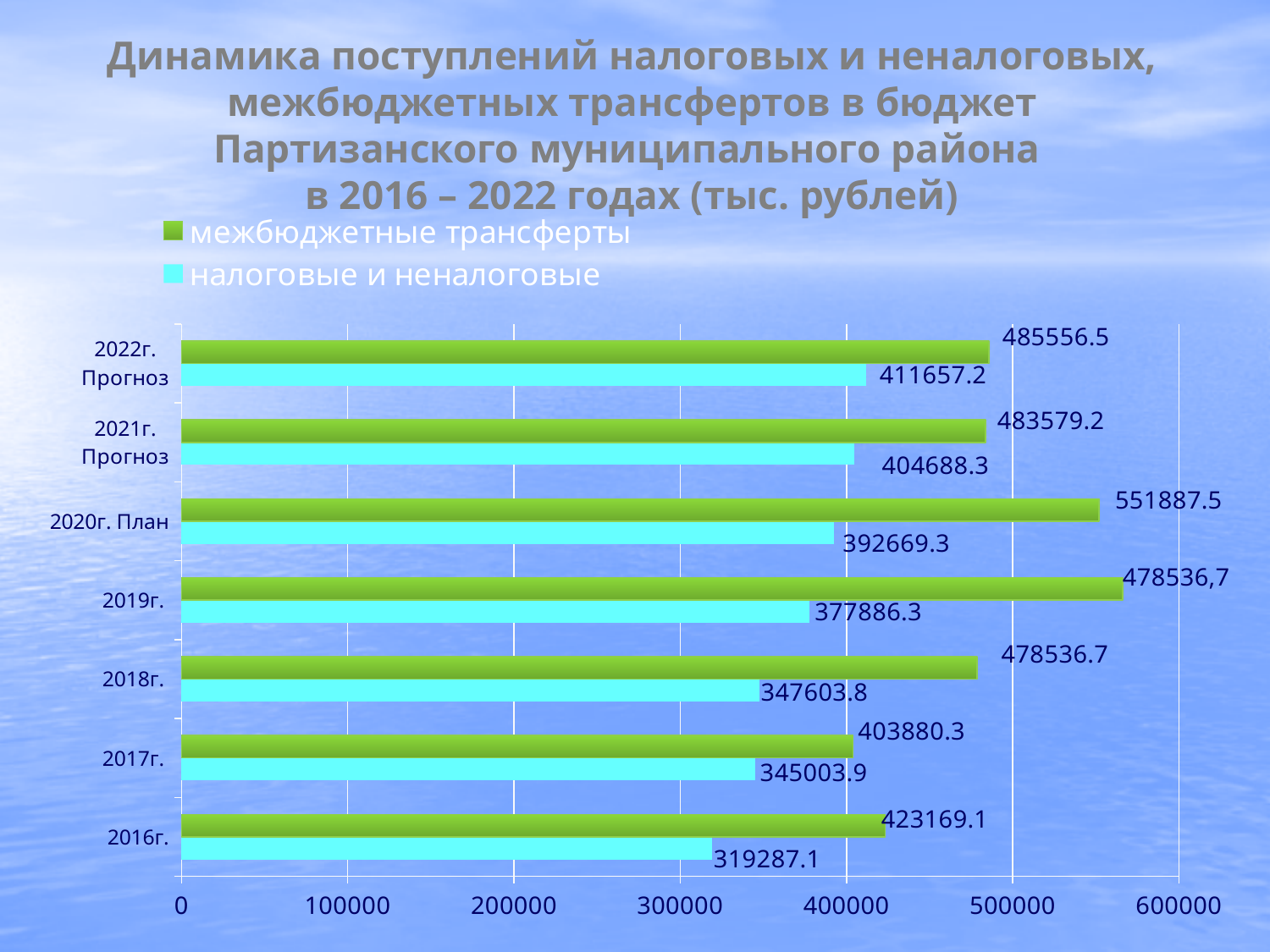
Which year has the larger value for межбюджетные трансферты, 2017г. or 2018г.? 2018г. Which category has the highest value for налоговые и неналоговые? 2022г. Прогноз What kind of chart is shown on the slide? bar chart Which category has the lowest value for налоговые и неналоговые? 2016г. How many series does the legend list? 2 For 2022г. Прогноз, what is the difference between межбюджетные трансферты and налоговые и неналоговые? 73899.3 What is the value of налоговые и неналоговые for 2022г. Прогноз? 411657.2 Do the values for налоговые и неналоговые rise or fall from 2016г. to 2022г. Прогноз? rise Is the bar for межбюджетные трансферты in 2019г. greater or less than 500000? greater What is the value of межбюджетные трансферты for 2020г. План? 551887.5 What is the value of налоговые и неналоговые for 2016г.? 319287.1 How many categories are shown on the vertical axis? 7